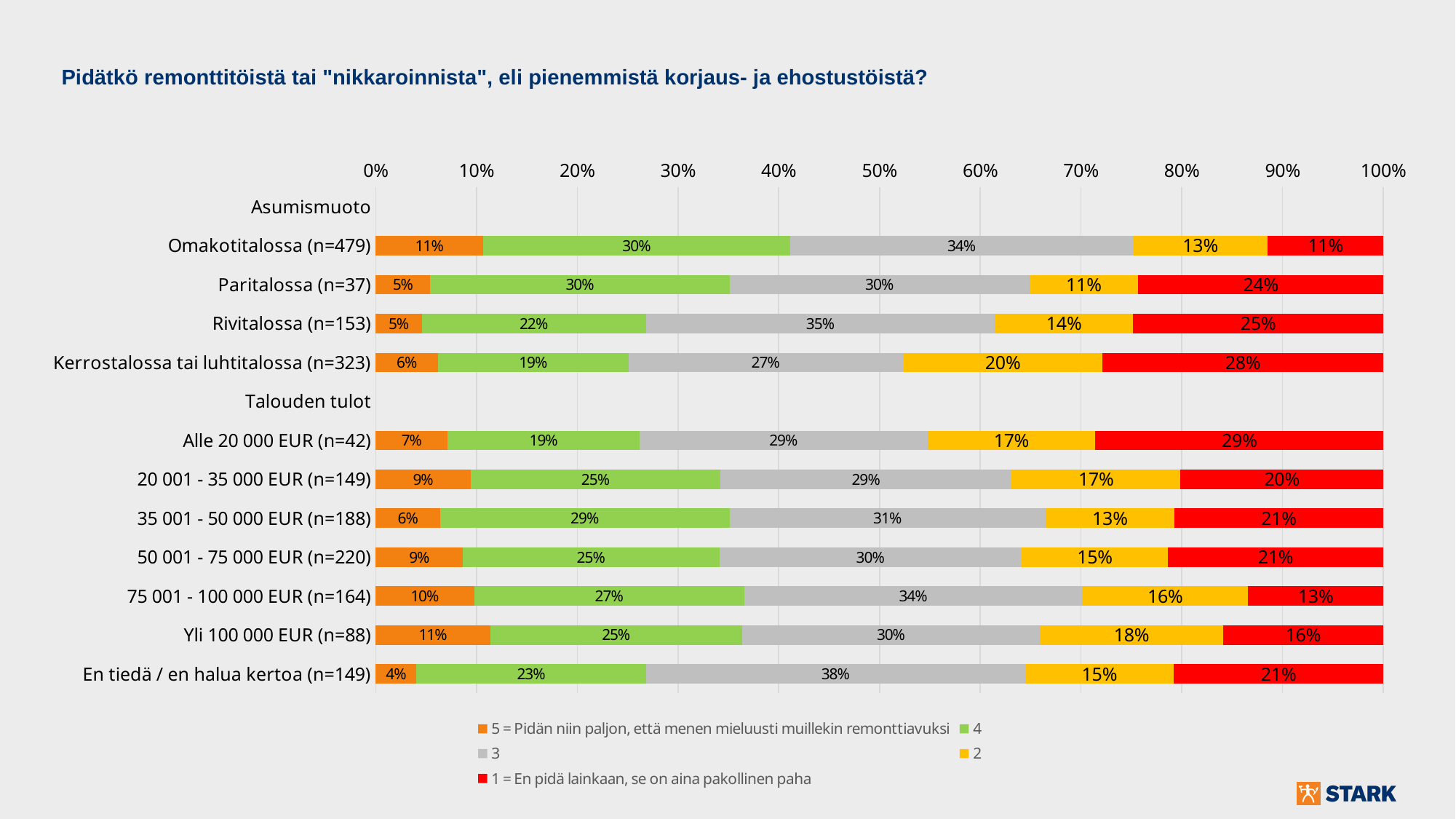
Which is larger: the share choosing answer 2 in the Kerrostalossa tai luhtitalossa (n=323) group or in the Paritalossa (n=37) group? Kerrostalossa tai luhtitalossa (n=323) How many series does the legend list? 5 What kind of chart is shown on the slide? Stacked bar chart What is the difference between the share choosing 1 = En pidä lainkaan in the Alle 20 000 EUR (n=42) group and in the 75 001 - 100 000 EUR (n=164) group? 16% What share of the Kerrostalossa tai luhtitalossa (n=323) group chose 1 = En pidä lainkaan, se on aina pakollinen paha? 28% What percentage of the Yli 100 000 EUR (n=88) group chose 5 = Pidän niin paljon, että menen mieluusti muillekin remonttiavuksi? 11% Which group has the lowest share for 5 = Pidän niin paljon, että menen mieluusti muillekin remonttiavuksi? En tiedä / en halua kertoa (n=149) Which group has the highest share for the answer 3? En tiedä / en halua kertoa (n=149) What colour represents the answer 1 = En pidä lainkaan, se on aina pakollinen paha? Red How many respondent groups (bars) are plotted in the chart? 11 What percentage of the En tiedä / en halua kertoa (n=149) group chose the answer 4? 23% What percentage of respondents in the Omakotitalossa (n=479) group chose the answer 3? 34%